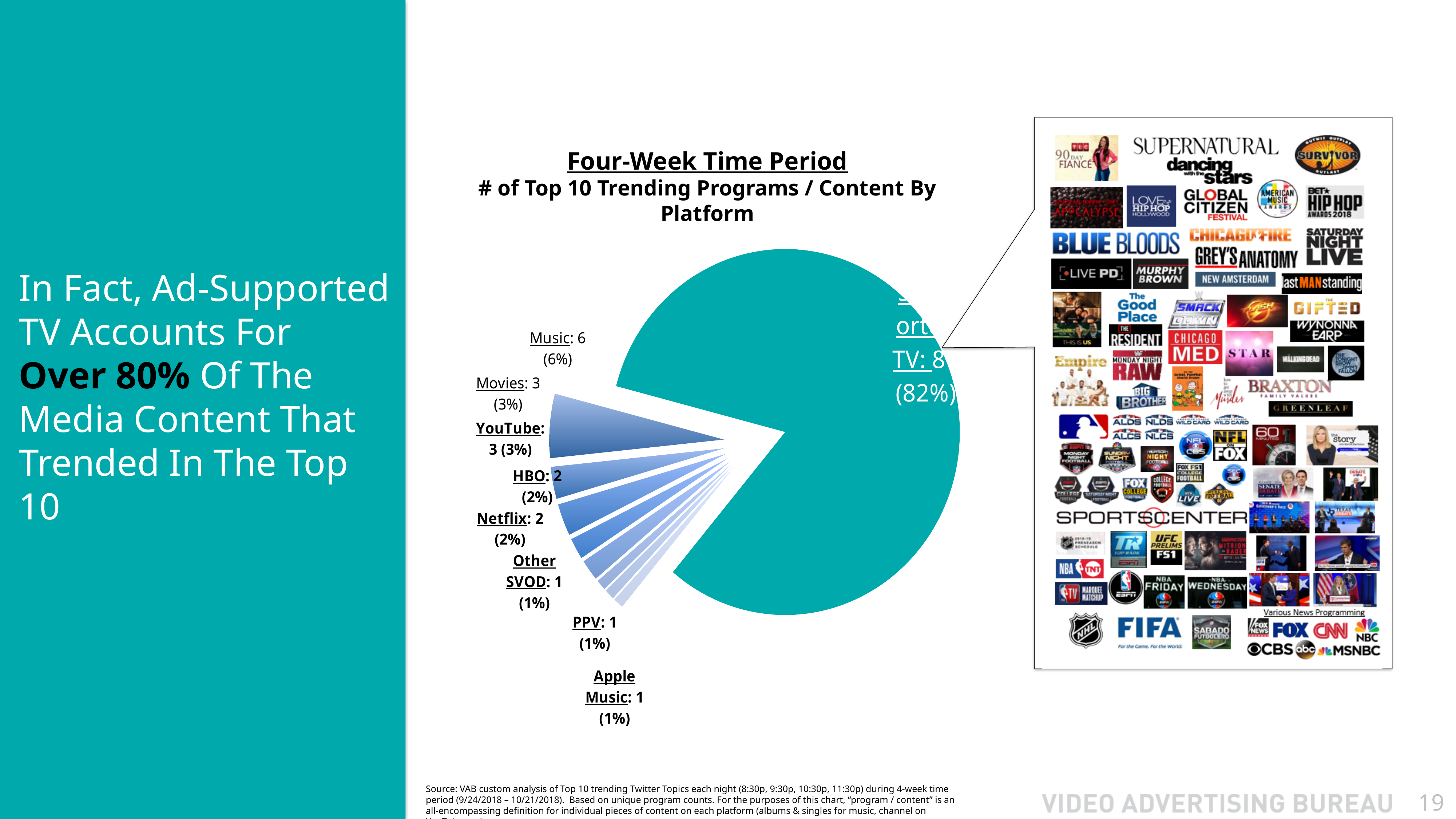
How many top 10 trending programs / content does the chart show for HBO? 2 Which has more top 10 trending programs / content, Music or Movies? Music What share of the pie does the largest slice (TV) represent? 82% How many top 10 trending programs / content does the chart show for PPV? 1 What kind of chart is shown on the slide? pie chart How many top 10 trending programs / content does the chart show for Netflix? 2 How many top 10 trending programs / content does the chart show for Music? 6 What is the difference between the number of trending programs / content for Music and for Movies? 3 How many top 10 trending programs / content does the chart show for YouTube? 3 Which platform has the largest slice of the pie? Ad-Supported TV What share of the pie does Music represent? 6% What is the title of the chart? Four-Week Time Period # of Top 10 Trending Programs / Content By Platform